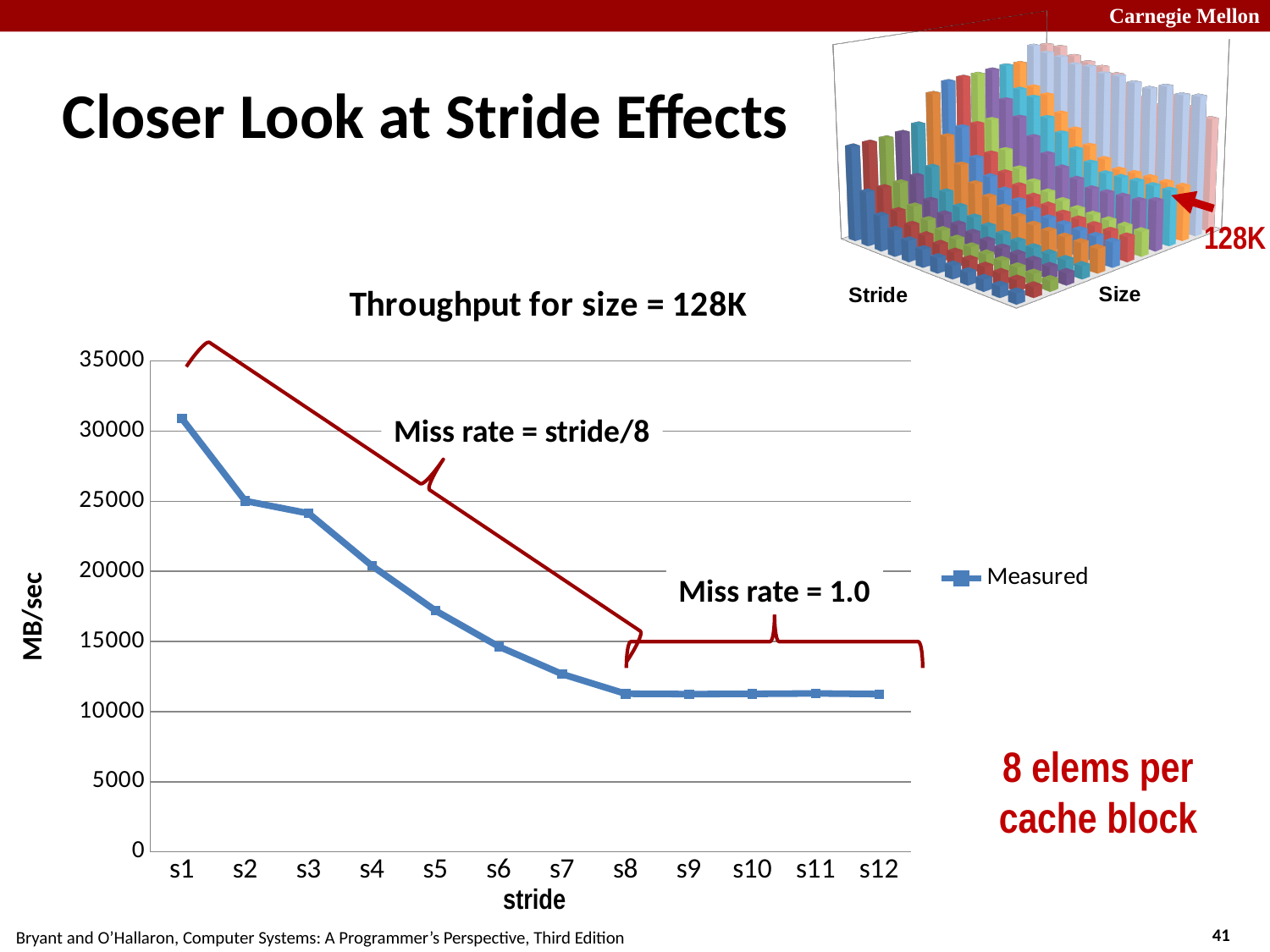
In the chart titled "Throughput for size = 128K", is the value for s1 greater or less than 25000? greater In the chart titled "Throughput for size = 128K", do the values rise or fall as stride increases from s1 to s8? fall In the chart titled "Throughput for size = 128K", which has the larger throughput, s3 or s7? s3 In the chart titled "Throughput for size = 128K", what kind of chart is used to plot the Measured series? line chart In the chart titled "Throughput for size = 128K", how many series does the legend list? 1 In the chart titled "Throughput for size = 128K", is the value for s10 greater or less than 10000? greater In the chart titled "Throughput for size = 128K", how many stride categories are shown on the x axis? 12 In the chart titled "Throughput for size = 128K", is the value for s4 greater or less than 15000? greater In the chart titled "Throughput for size = 128K", what is the name of the series in the legend? Measured In the chart titled "Throughput for size = 128K", what is the label on the y axis? MB/sec In the chart titled "Throughput for size = 128K", which stride has the highest throughput? s1